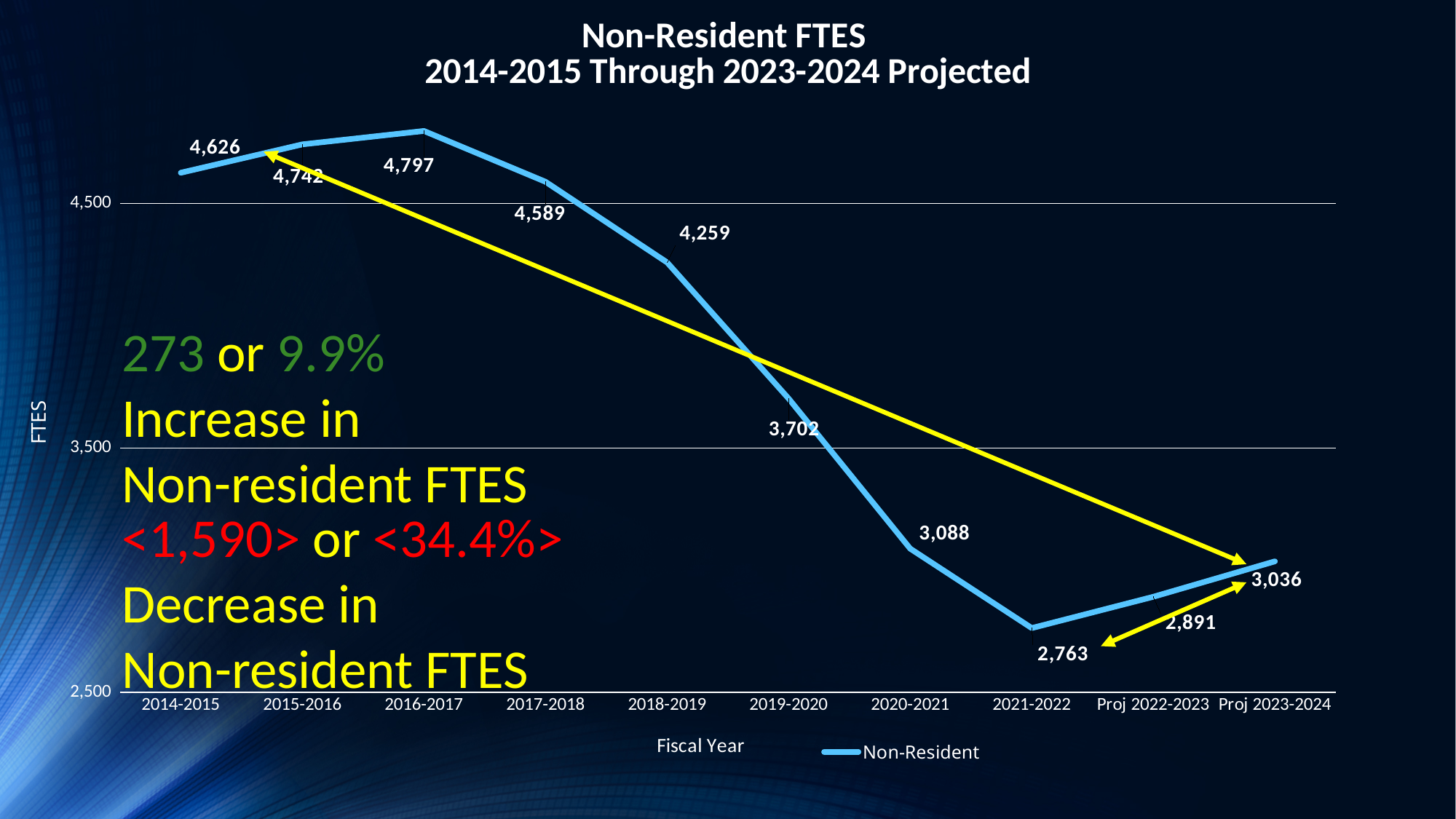
What kind of chart is shown on the slide? Line chart What is the projected Non-Resident FTES value for Proj 2023-2024? 3,036 What is the Non-Resident FTES value for 2021-2022? 2,763 Which is larger, the Non-Resident FTES value for 2018-2019 or for 2020-2021? 2018-2019 What is the Non-Resident FTES value for 2019-2020? 3,702 Which fiscal year has the lowest Non-Resident FTES value? 2021-2022 Which fiscal year has the highest Non-Resident FTES value? 2016-2017 What is the title of the x axis? Fiscal Year How many fiscal years are plotted on the x axis? 10 What is the difference between the Non-Resident FTES values for 2014-2015 and Proj 2023-2024? 1,590 What is the Non-Resident FTES value for 2016-2017? 4,797 What is the difference between the Non-Resident FTES values for 2016-2017 and 2021-2022? 2,034